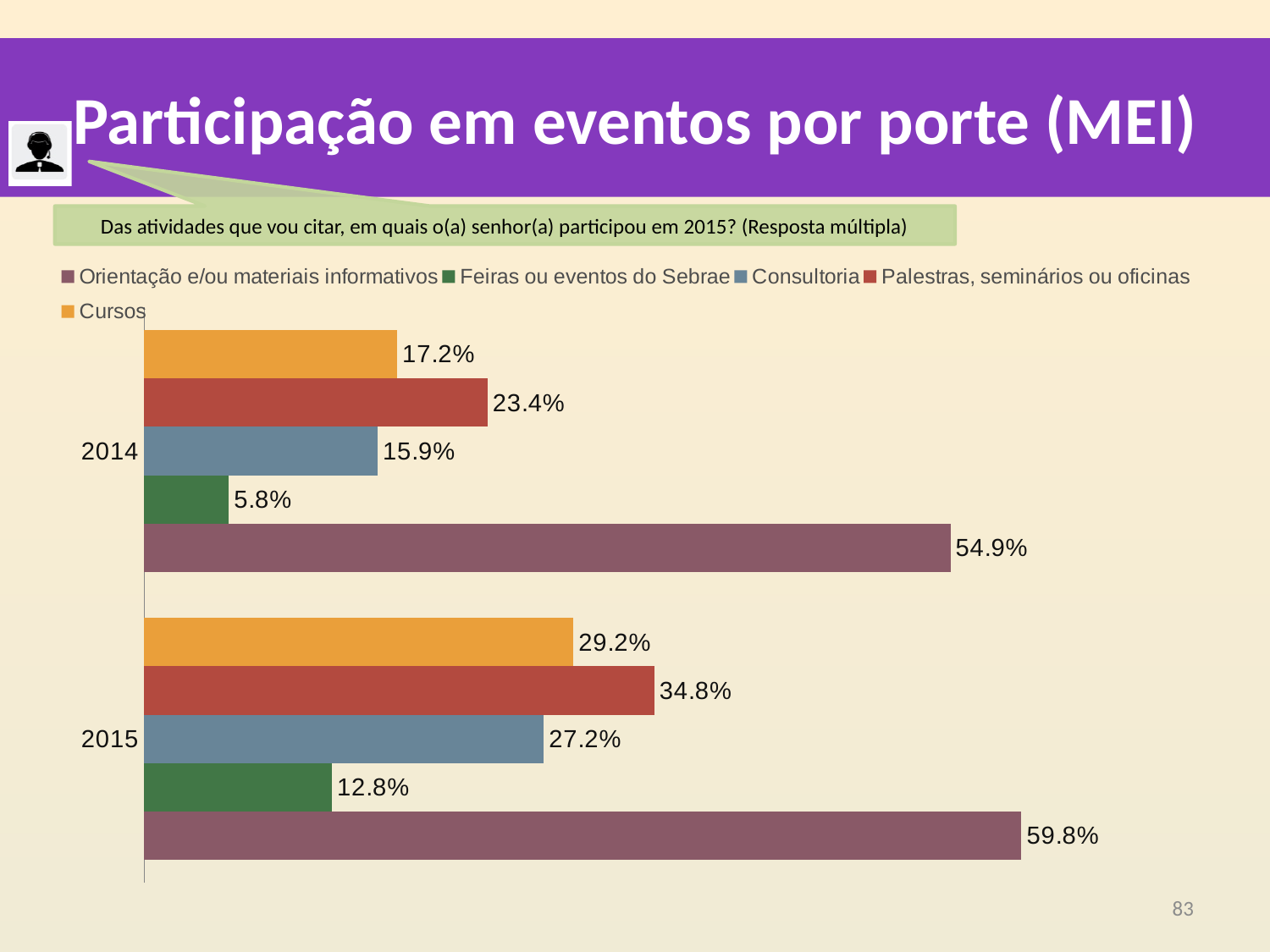
What is the value for Consultoria in 2015? 27.2% What is the value for Cursos in 2014? 17.2% How many year categories are shown on the chart? 2 Which series has the lowest value in 2014? Feiras ou eventos do Sebrae What kind of chart is shown on the slide? Bar chart What is the value for Palestras, seminários ou oficinas in 2015? 34.8% What is the difference between the Cursos values for 2015 and 2014? 12.0% What is the value for Feiras ou eventos do Sebrae in 2014? 5.8% How many series does the legend list? 5 What is the difference between the Orientação e/ou materiais informativos values for 2015 and 2014? 4.9% Which series has the highest value in 2015? Orientação e/ou materiais informativos Which is larger in 2014: Cursos or Consultoria? Cursos